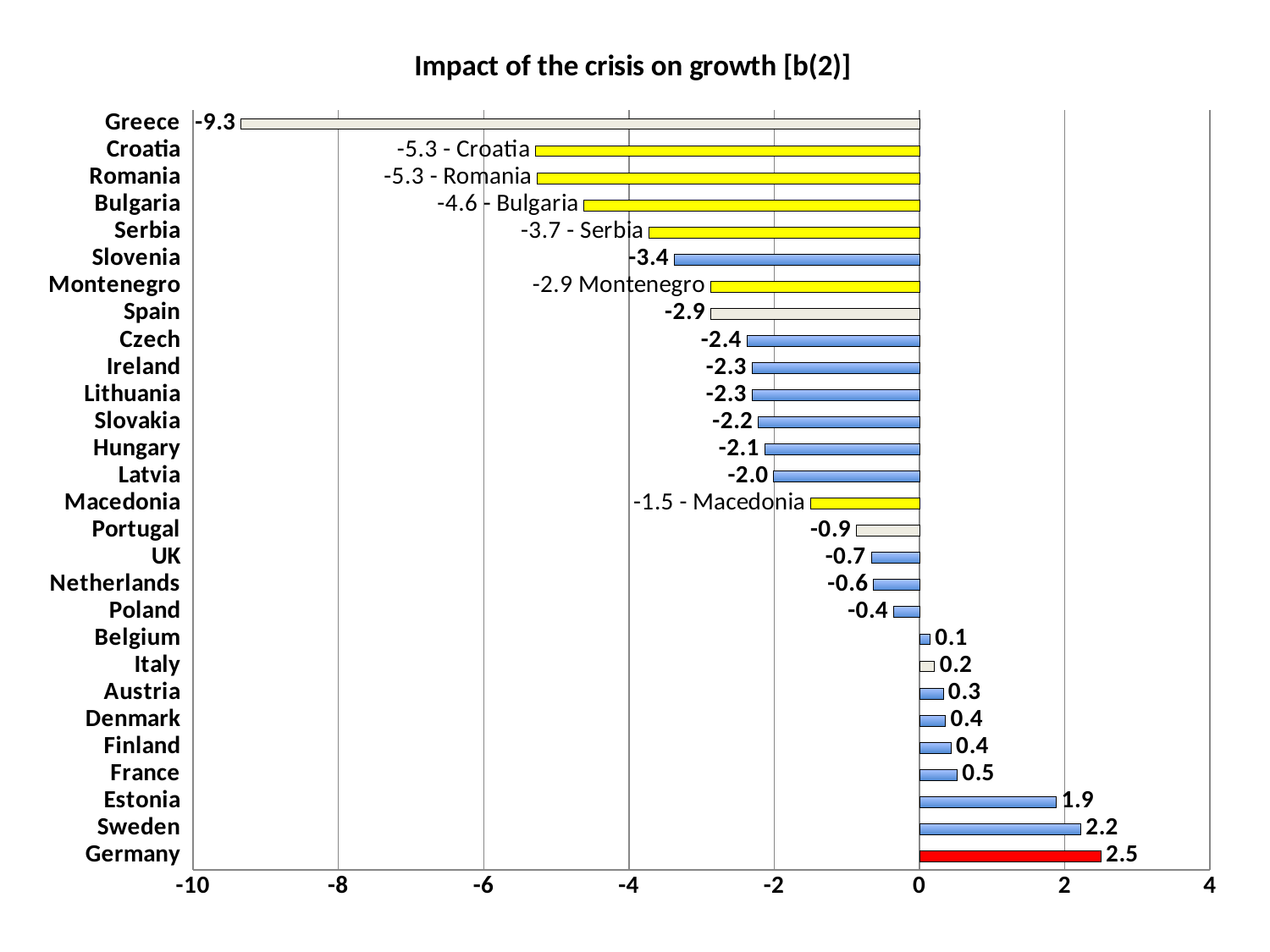
What kind of chart is this? Bar chart What is the difference between the values for Greece and Croatia? 4.0 What is the value for Greece? -9.3 How many countries are shown in the chart? 28 What is the value for Germany? 2.5 What is the value for Montenegro? -2.9 Which country has the highest value? Germany What is the value for Hungary? -2.1 Which has a larger value, Bulgaria or Serbia? Serbia What is the difference between the values for Sweden and Estonia? 0.3 What is the title of the chart? Impact of the crisis on growth [b(2)] Which country has the lowest value? Greece